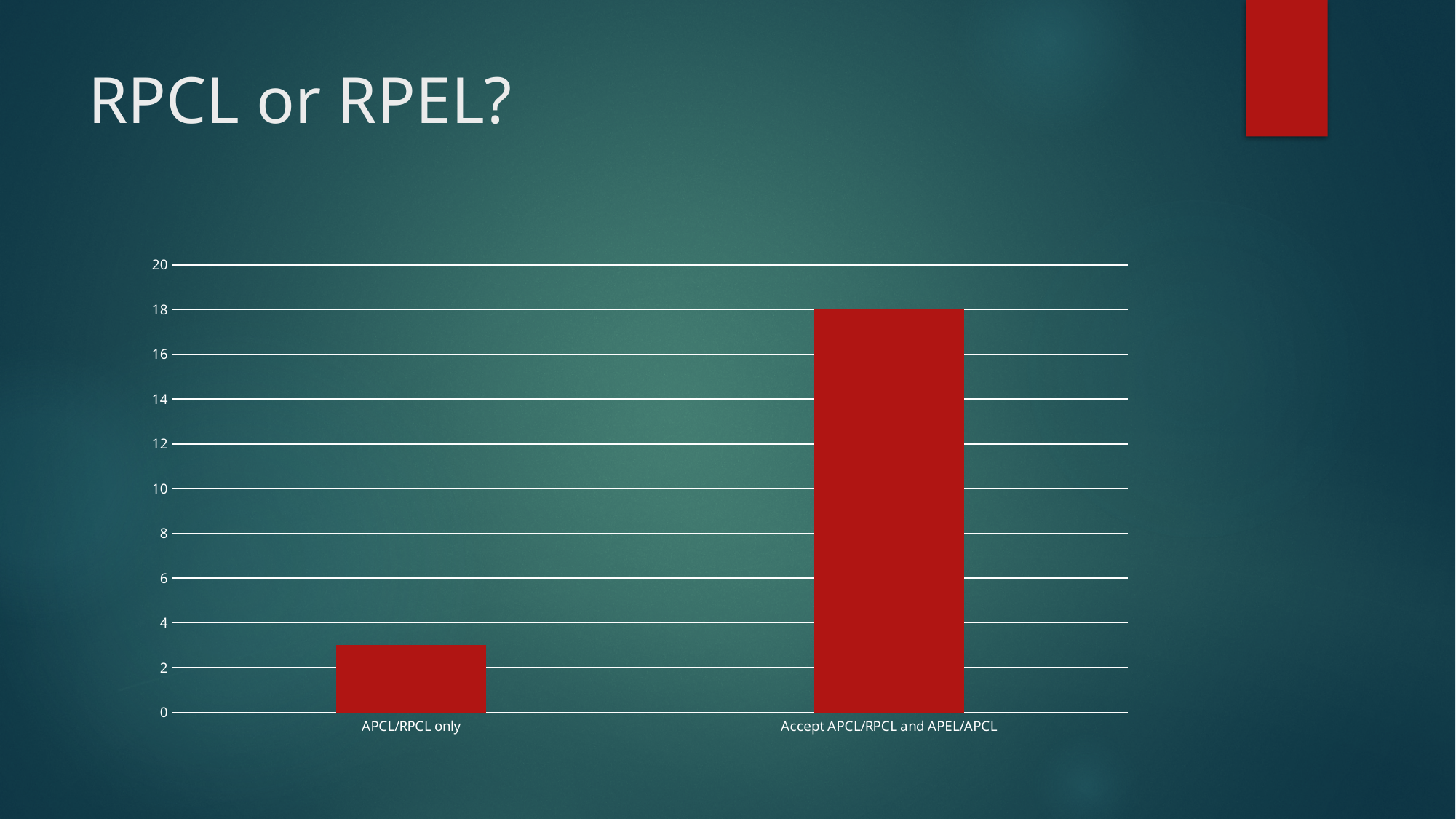
Which is larger, the value for APCL/RPCL only or the value for Accept APCL/RPCL and APEL/APCL? Accept APCL/RPCL and APEL/APCL Is the value for APCL/RPCL only greater or less than 2? greater Is the value for Accept APCL/RPCL and APEL/APCL greater or less than 10? greater What colour are the bars in the chart? red Which category has the lowest value? APCL/RPCL only What kind of chart is shown on the slide? bar chart Is the value for APCL/RPCL only greater or less than 4? less What is the value for Accept APCL/RPCL and APEL/APCL? 18 How many categories are shown on the x axis? 2 Which category has the highest value? Accept APCL/RPCL and APEL/APCL What is the title of the slide? RPCL or RPEL?